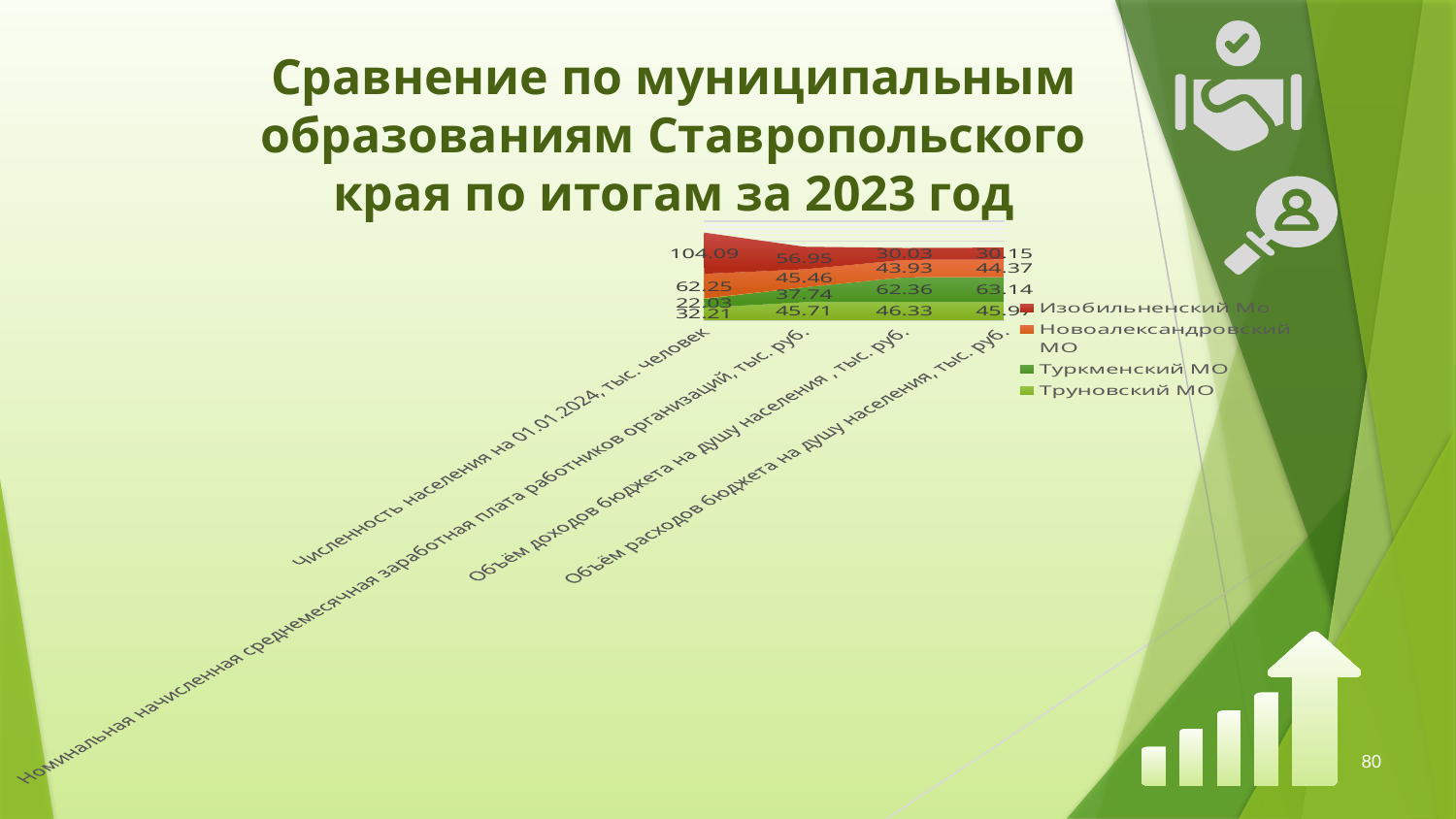
What kind of chart is shown on the slide? Area chart What is the value for Труновский МО for Объём расходов бюджета на душу населения, тыс. руб.? 45.97 Which municipality has the lowest value for Численность населения на 01.01.2024, тыс. человек? Туркменский МО Which municipality has the highest value for Численность населения на 01.01.2024, тыс. человек? Изобильненский МО What is the value for Изобильненский МО for Численность населения на 01.01.2024, тыс. человек? 104.09 How many series does the legend list? 4 How many categories are shown along the x axis? 4 What is the difference between Изобильненский МО and Новоалександровский МО for Численность населения на 01.01.2024, тыс. человек? 41.84 What is the value for Туркменский МО for Численность населения на 01.01.2024, тыс. человек? 22.03 Do the values for Туркменский МО rise or fall from the first category to the last along the x axis? Rise Which is larger for Объём доходов бюджета на душу населения, тыс. руб.: Туркменский МО or Изобильненский МО? Туркменский МО What is the value for Новоалександровский МО for Объём доходов бюджета на душу населения, тыс. руб.? 43.93